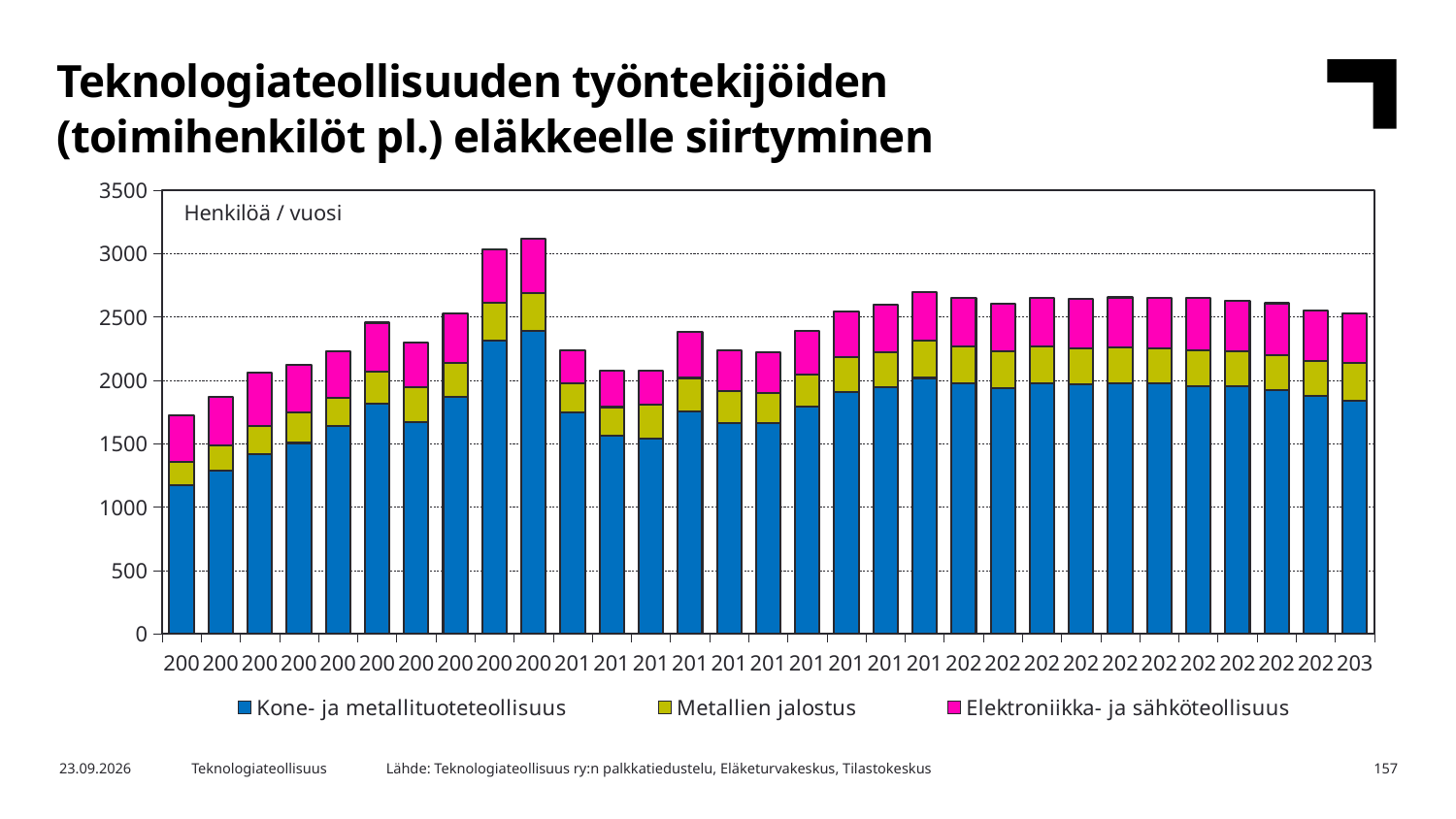
How many bars are plotted in the chart? 31 What kind of chart is shown on the slide? Stacked bar chart Which series forms the largest segment in every bar? Kone- ja metallituoteteollisuus What unit label is printed inside the plot area at the top left? Henkilöä / vuosi Is the Kone- ja metallituoteteollisuus segment of the leftmost bar greater or less than 1000? greater In the leftmost bar, which segment is larger: Metallien jalostus or Elektroniikka- ja sähköteollisuus? Elektroniikka- ja sähköteollisuus Is the total of the leftmost bar greater or less than 2000? less How many series does the legend list? 3 Do the bar totals generally rise or fall from the leftmost bar to the tallest bar? rise Which series is shown in magenta/pink in the legend? Elektroniikka- ja sähköteollisuus Is the total of the tallest stacked bar greater or less than 3000? greater